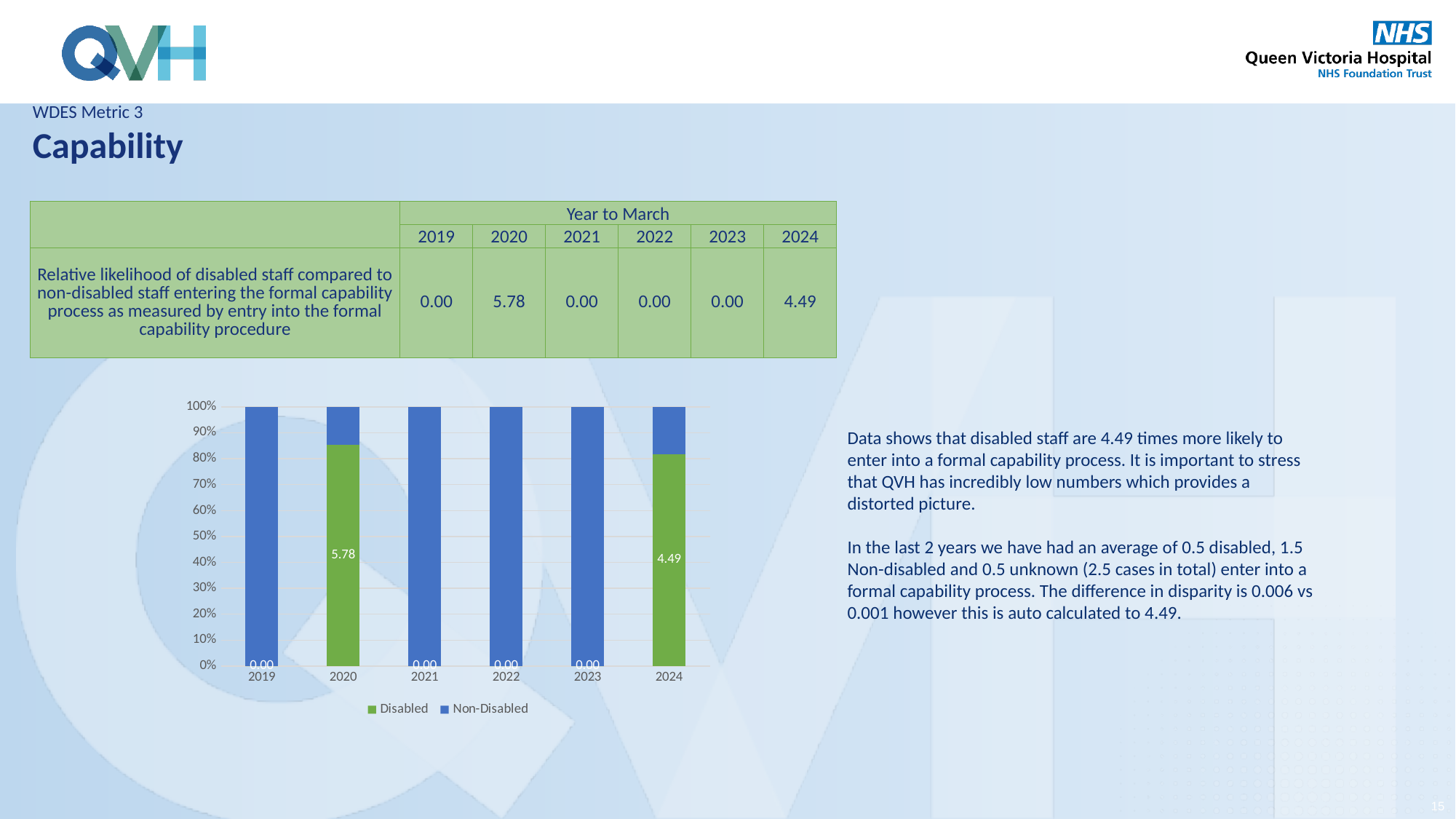
What is the Disabled value labelled on the bar for 2020? 5.78 How many years are shown on the x axis of the chart? 6 Which year has the highest labelled Disabled value? 2020 How many series does the chart legend list? 2 What is the Disabled value labelled on the bar for 2021? 0.00 What is the difference between the labelled Disabled values for 2020 and 2024? 1.29 What is the Disabled value labelled on the bar for 2024? 4.49 Is the green Disabled segment for 2020 greater or less than 80% of the bar? greater Which colour represents the Non-Disabled series in the chart? blue Is the green Disabled segment for 2024 greater or less than 90% of the bar? less Which is larger, the labelled Disabled value for 2020 or for 2024? 2020 What type of chart is shown on the slide? bar chart